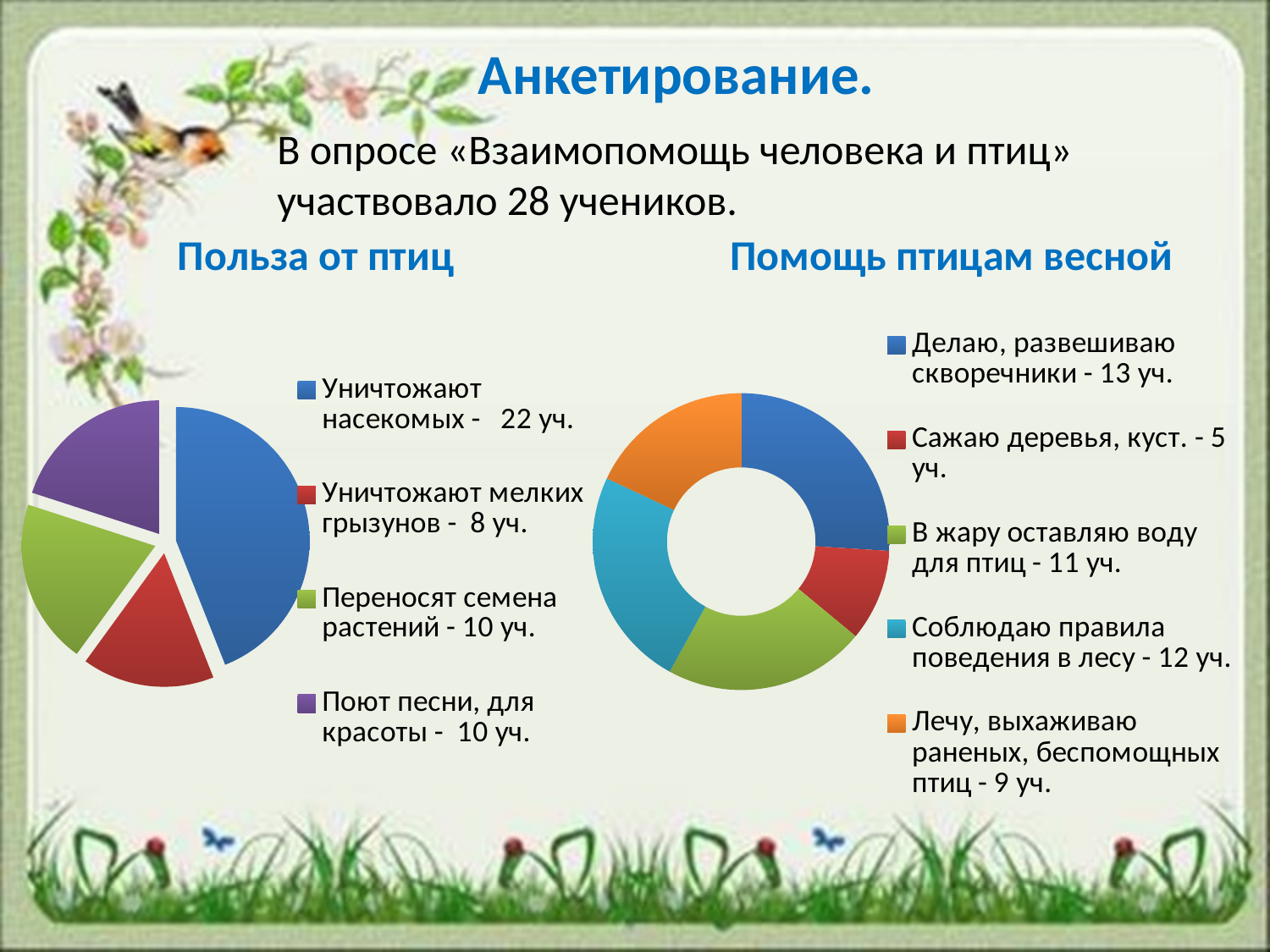
In the 'Помощь птицам весной' chart, how many students chose 'Сажаю деревья, куст.'? 5 уч. How many categories does the 'Польза от птиц' chart show? 4 In the 'Помощь птицам весной' chart, what colour is the 'Соблюдаю правила поведения в лесу' segment? Light blue In the 'Польза от птиц' chart, which category has the highest value? Уничтожают насекомых In the 'Помощь птицам весной' chart, which is larger: 'В жару оставляю воду для птиц' or 'Лечу, выхаживаю раненых, беспомощных птиц'? В жару оставляю воду для птиц What kind of chart is the 'Польза от птиц' chart? Pie chart In the 'Помощь птицам весной' chart, what is the difference between 'Соблюдаю правила поведения в лесу' and 'Сажаю деревья, куст.'? 7 In the 'Польза от птиц' chart, what is the difference between 'Уничтожают насекомых' and 'Уничтожают мелких грызунов'? 14 In the 'Польза от птиц' chart, which category has the lowest value? Уничтожают мелких грызунов How many categories does the 'Помощь птицам весной' chart show? 5 In the 'Польза от птиц' chart, how many students chose 'Уничтожают насекомых'? 22 уч. In the 'Помощь птицам весной' chart, which category has the highest value? Делаю, развешиваю скворечники